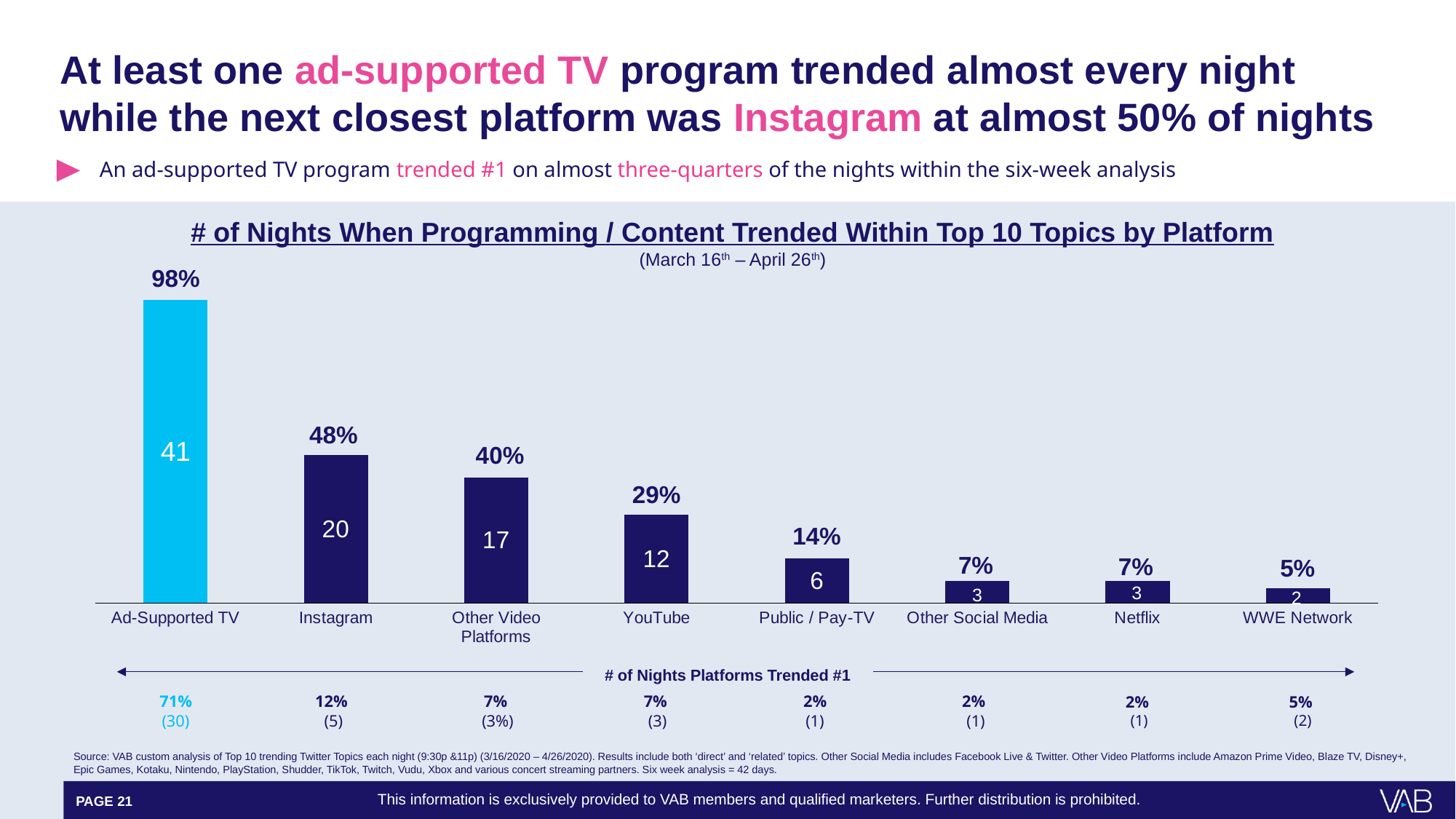
Which platform has the highest number of nights in the chart? Ad-Supported TV What kind of chart is shown on the slide? Bar chart Which has more nights, Other Video Platforms or YouTube? Other Video Platforms What is the title of the chart? # of Nights When Programming / Content Trended Within Top 10 Topics by Platform What is the number of nights shown for Public / Pay-TV? 6 What percentage is shown above the Netflix bar? 7% How many platforms are shown on the x axis of the chart? 8 What is the difference in number of nights between Ad-Supported TV and Instagram? 21 Do the values rise or fall moving from left to right along the x axis? Fall Which platform has the lowest number of nights in the chart? WWE Network What percentage is shown above the YouTube bar? 29% What is the number of nights shown for Instagram? 20